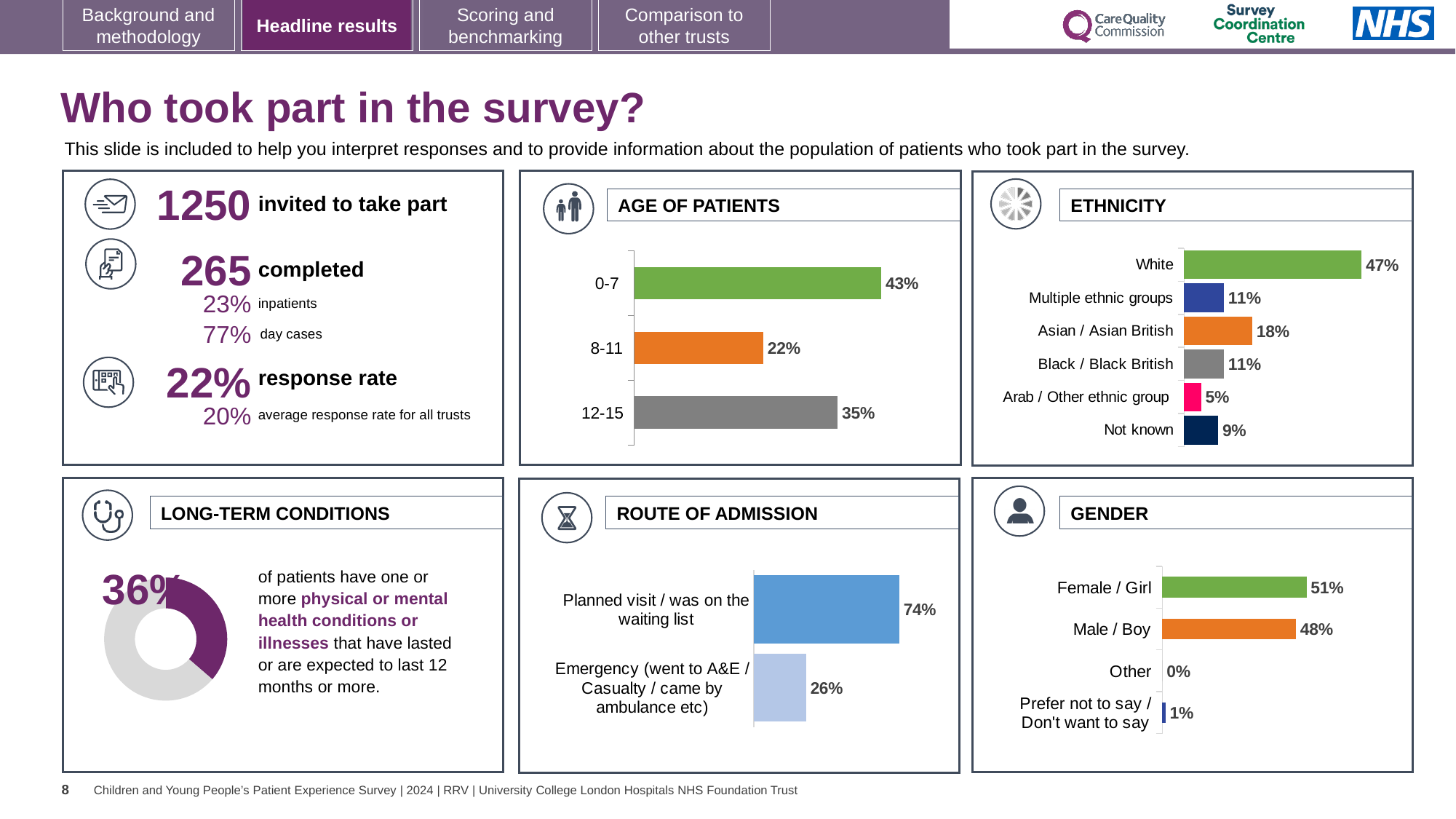
In the ETHNICITY chart, how many ethnicity categories are shown? 6 In the ETHNICITY chart, which is larger: Arab / Other ethnic group or Not known? Not known In the AGE OF PATIENTS chart, what percentage of patients are aged 0-7? 43% In the ROUTE OF ADMISSION chart, what is the difference between the Planned visit and Emergency percentages? 48% In the ETHNICITY chart, which category has the highest percentage? White In the ROUTE OF ADMISSION chart, what percentage of patients came via Emergency (went to A&E / Casualty / came by ambulance etc)? 26% What type of chart is used in the LONG-TERM CONDITIONS panel? Doughnut chart In the ETHNICITY chart, what percentage of patients are Asian / Asian British? 18% In the AGE OF PATIENTS chart, what is the difference between the 0-7 and 12-15 percentages? 8% In the GENDER chart, which category has the highest percentage? Female / Girl In the GENDER chart, what percentage of patients are Male / Boy? 48% In the AGE OF PATIENTS chart, which age group has the lowest percentage? 8-11